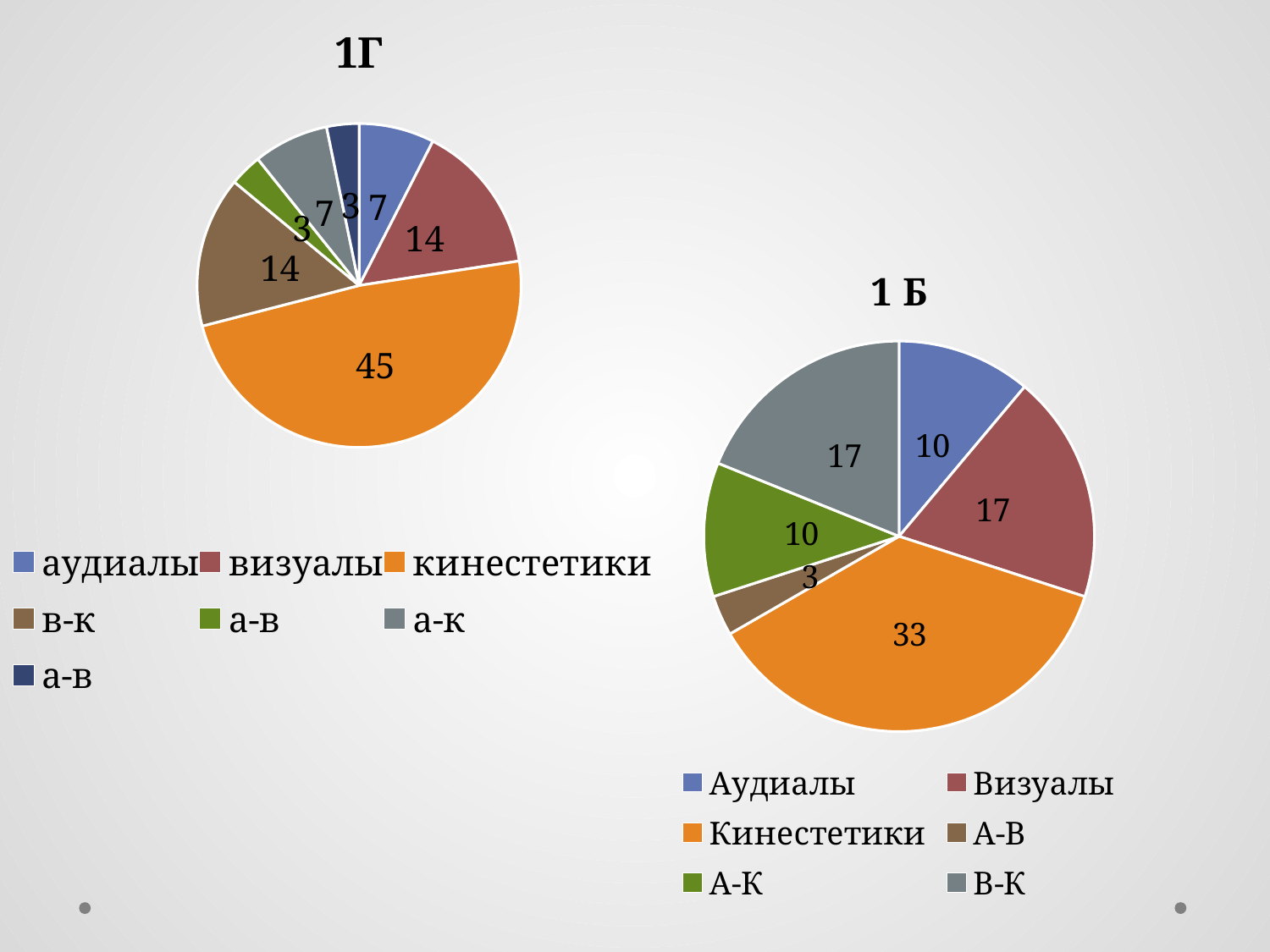
In the chart titled 1Г, which category has the largest slice? кинестетики In the chart titled 1 Б, what is the value for Аудиалы? 10 In the chart titled 1 Б, what is the value for Кинестетики? 33 What type of chart is the chart titled 1Г? pie chart In the chart titled 1Г, what is the difference between the values for кинестетики and визуалы? 31 In the chart titled 1 Б, which category has the smallest slice? А-В How many slices does the chart titled 1Г have? 7 How many entries does the legend of the chart titled 1 Б list? 6 In the chart titled 1 Б, what is the difference between the values for Визуалы and Аудиалы? 7 In the chart titled 1 Б, which is larger: Визуалы or А-К? Визуалы In the chart titled 1Г, what is the value for кинестетики? 45 In the chart titled 1Г, what is the value for визуалы? 14